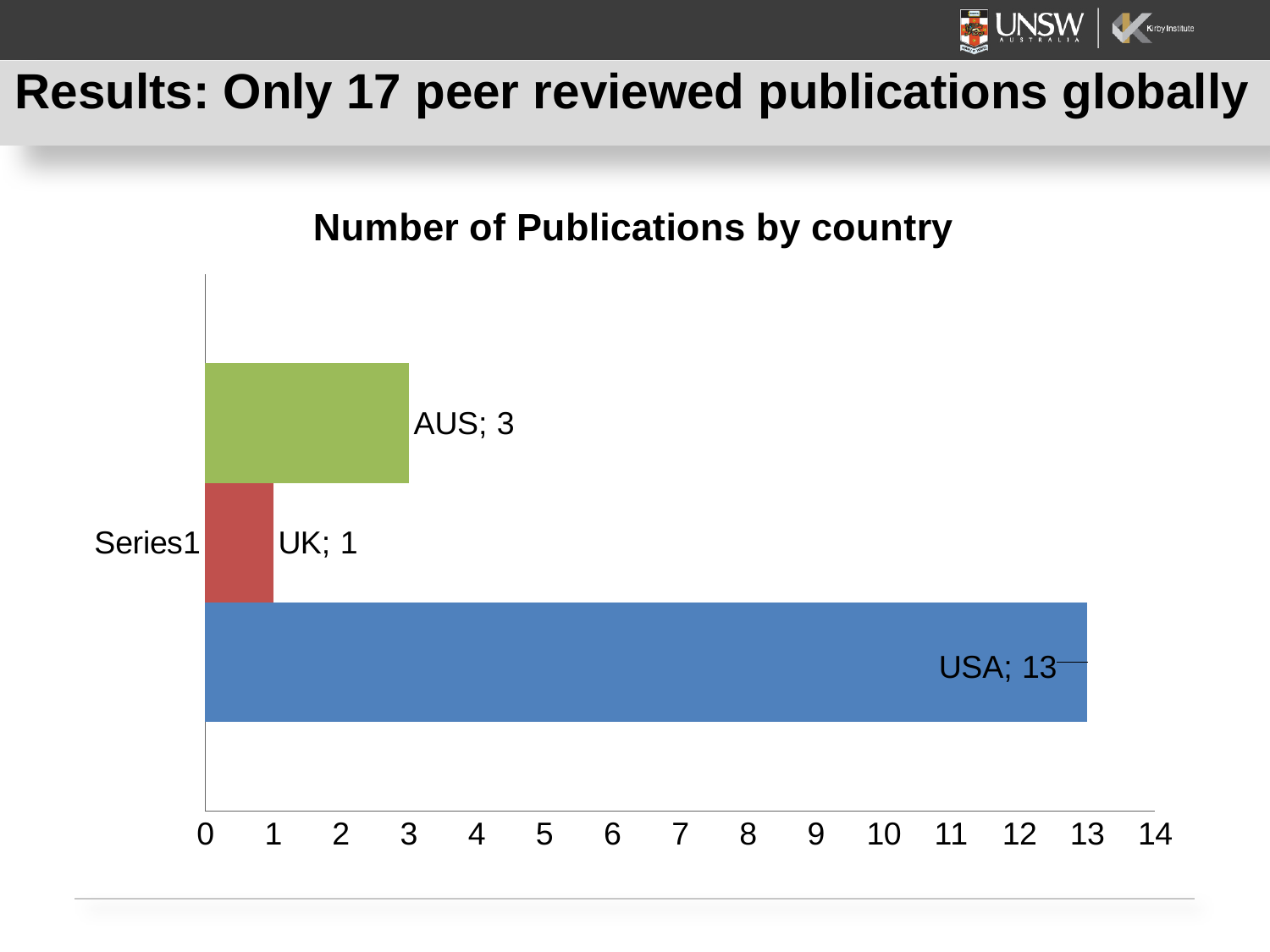
What is the difference between the number of publications for AUS and UK? 2 Which country has the lowest number of publications? UK Which has more publications, AUS or UK? AUS Is the value for USA greater or less than 10? greater What is the number of publications for UK? 1 What kind of chart is shown on the slide? bar chart What is the title of the chart? Number of Publications by country How many countries are shown in the chart? 3 Which country has the highest number of publications? USA What is the number of publications for AUS? 3 What is the difference between the number of publications for USA and AUS? 10 What is the number of publications for USA? 13